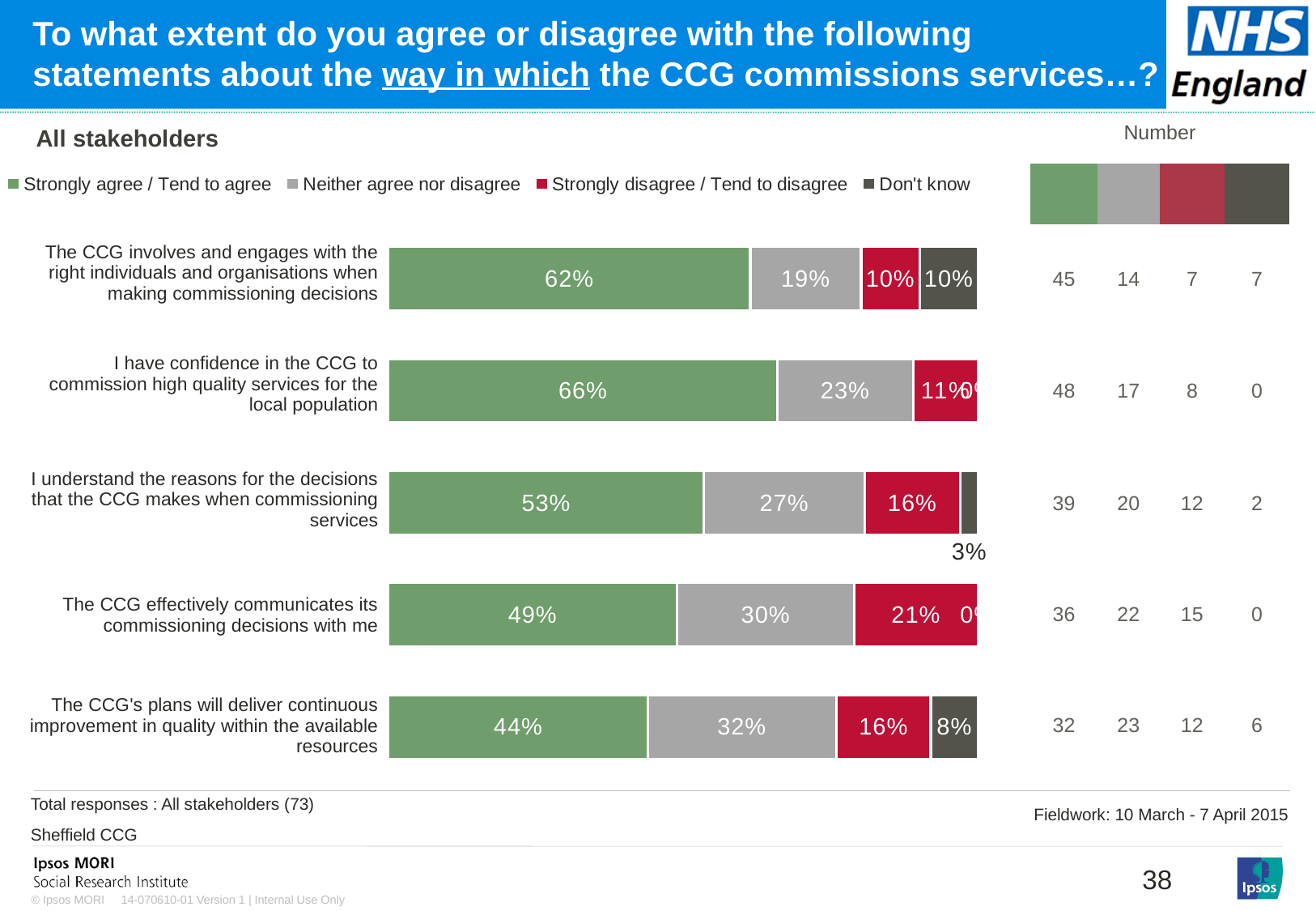
What percentage strongly disagree or tend to disagree that the CCG effectively communicates its commissioning decisions with them? 21% In the 'Number' column, how many stakeholders strongly agree or tend to agree that the CCG involves and engages with the right individuals and organisations when making commissioning decisions? 45 What percentage neither agree nor disagree that the CCG's plans will deliver continuous improvement in quality within the available resources? 32% How many response categories does the legend list? 4 What percentage of stakeholders strongly agree or tend to agree that they have confidence in the CCG to commission high quality services for the local population? 66% Which statement has a larger 'Neither agree nor disagree' share: 'I understand the reasons for the decisions that the CCG makes when commissioning services' or 'The CCG effectively communicates its commissioning decisions with me'? The CCG effectively communicates its commissioning decisions with me How many statements are shown in the chart? 5 What type of chart is used on this slide? Stacked bar chart Which statement has the highest percentage of stakeholders who strongly disagree or tend to disagree? The CCG effectively communicates its commissioning decisions with me Which statement has the lowest percentage of stakeholders who strongly agree or tend to agree? The CCG's plans will deliver continuous improvement in quality within the available resources Which statement has the highest percentage of stakeholders who strongly agree or tend to agree? I have confidence in the CCG to commission high quality services for the local population What is the difference in percentage points between the agree share for 'The CCG involves and engages with the right individuals and organisations when making commissioning decisions' and the agree share for 'The CCG's plans will deliver continuous improvement in quality within the available resources'? 18 percentage points